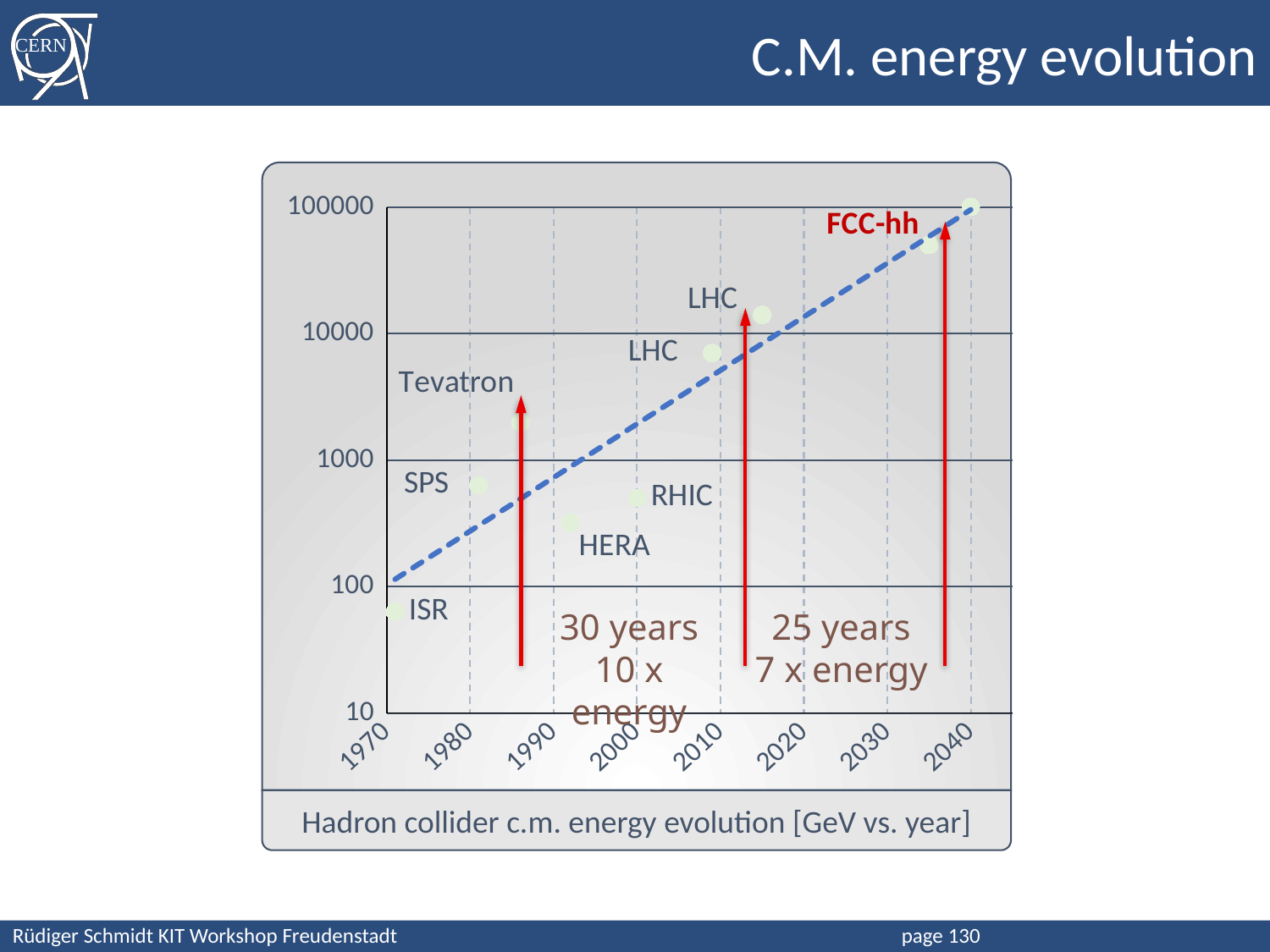
Is the c.m. energy for SPS greater or less than 1000 GeV? less Is the c.m. energy for FCC-hh greater or less than 10000 GeV? greater Is the c.m. energy for ISR greater or less than 100 GeV? less Which has the higher c.m. energy, Tevatron or HERA? Tevatron What is the caption printed below the chart? Hadron collider c.m. energy evolution [GeV vs. year] Which collider has the lowest c.m. energy on the chart? ISR What kind of chart is shown on the slide? scatter chart According to the annotation on the chart, by what factor did the energy increase over the 25-year span? 7 x energy Which collider has the highest c.m. energy on the chart? FCC-hh Do the c.m. energies rise or fall as the year increases along the x axis? rise